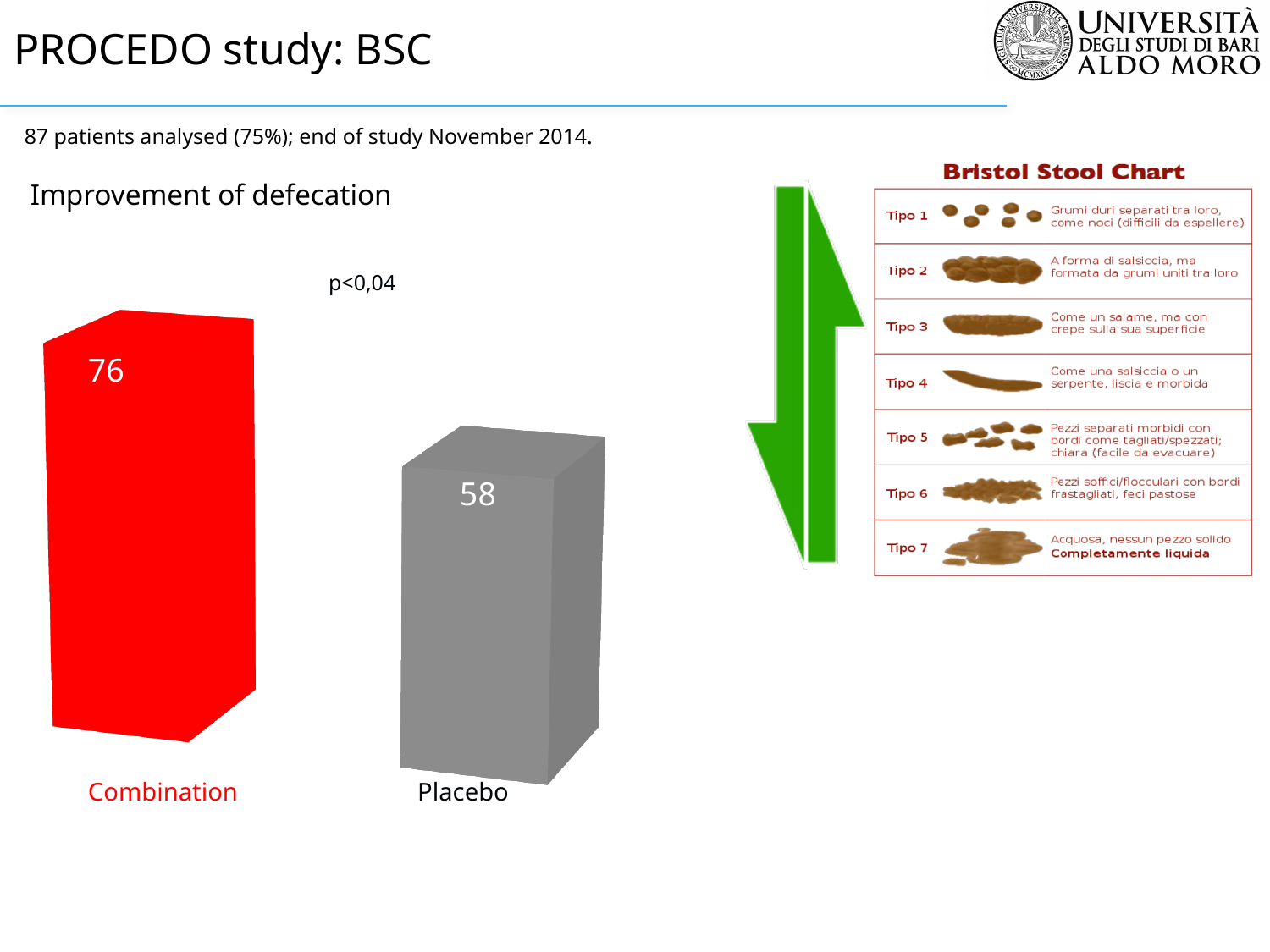
What is the difference between the Combination and Placebo values in the Improvement of defecation chart? 18 What p-value is shown on the Improvement of defecation chart? p<0,04 Which category has the highest value in the Improvement of defecation chart? Combination How many categories are shown in the Improvement of defecation chart? 2 Which category has the lowest value in the Improvement of defecation chart? Placebo What kind of chart is the Improvement of defecation chart? bar chart What is the value for Placebo in the Improvement of defecation chart? 58 Which is larger in the Improvement of defecation chart, Combination or Placebo? Combination What is the value for Combination in the Improvement of defecation chart? 76 What colour is the Combination bar in the Improvement of defecation chart? red